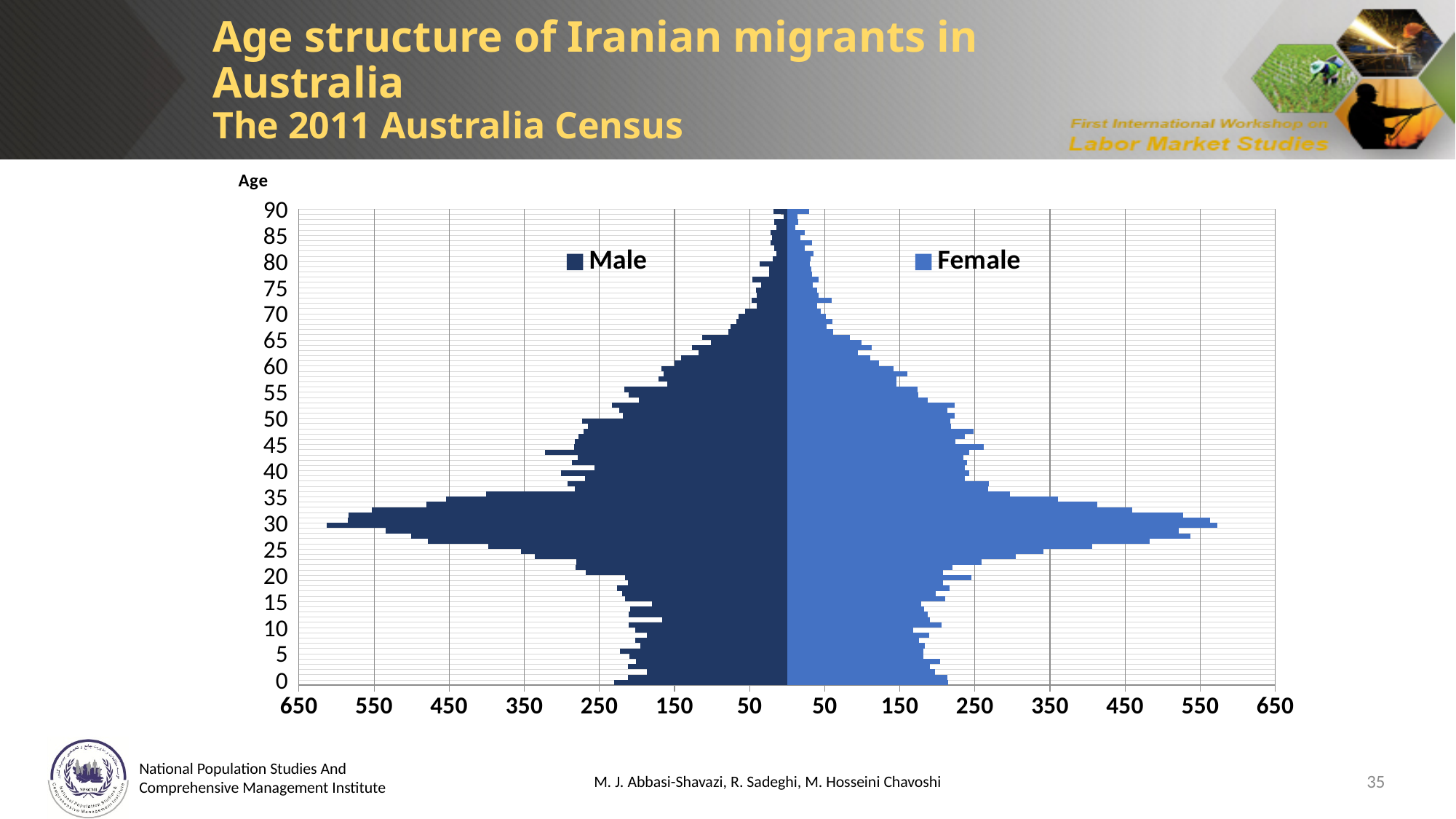
Is the Female value at age 0 greater or less than 150? greater What are the two series named in the legend? Male and Female What is the highest age label shown on the vertical axis? 90 What kind of chart is shown on the slide? bar chart (population pyramid) Is the Male value at age 30 greater or less than 550? greater Is the Female value at age 55 greater or less than 250? less At which age is the Male bar the longest? 30 How many series does the legend list? 2 Do the Male bars generally get shorter or longer as age increases from 30 to 90? shorter